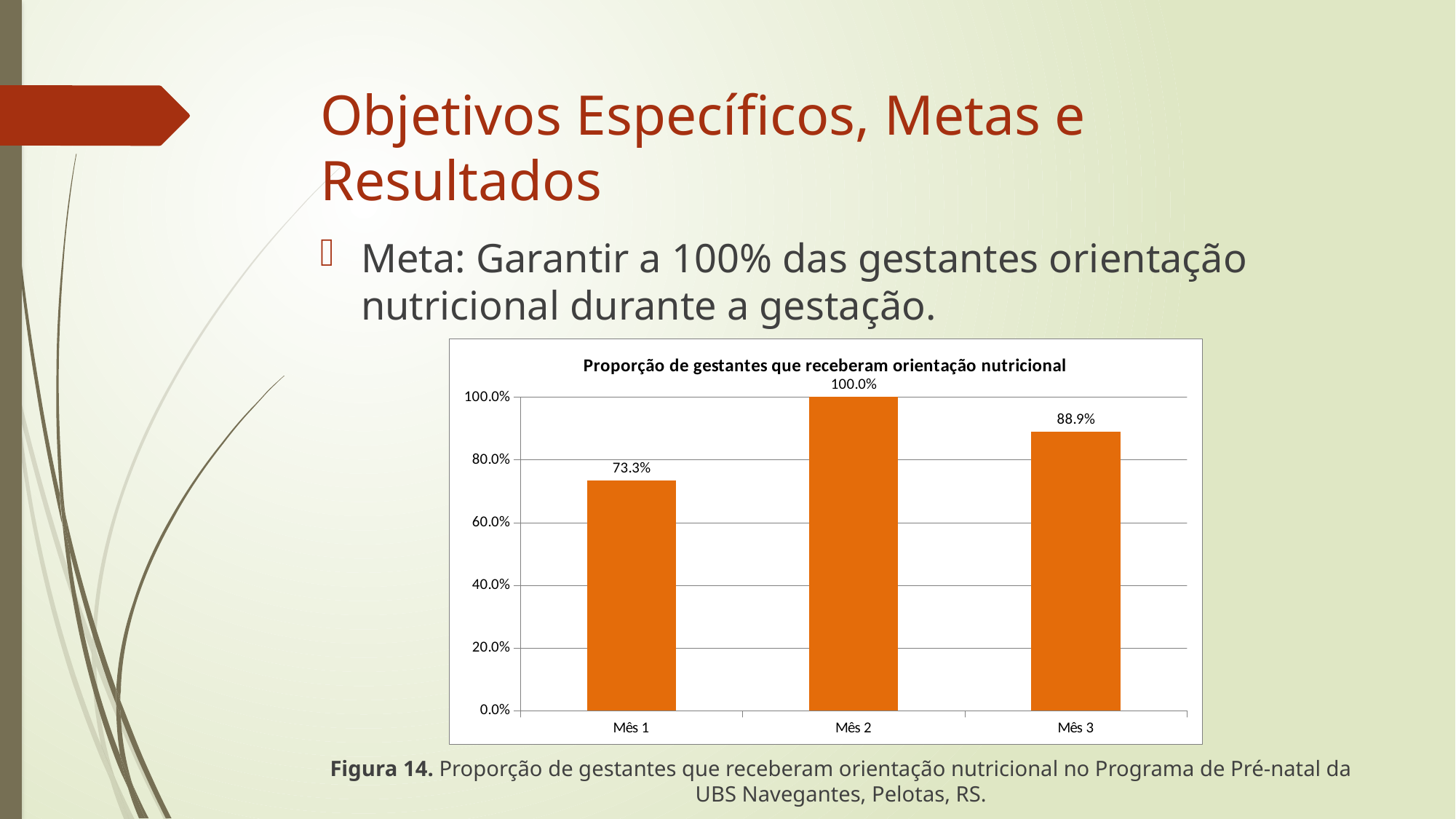
Which month has the highest proportion? Mês 2 What is the title of the chart? Proporção de gestantes que receberam orientação nutricional How many months are shown on the x axis? 3 What is the value for Mês 2? 100.0% What is the difference between the values for Mês 3 and Mês 1? 15.6% What is the difference between the values for Mês 2 and Mês 1? 26.7% Which is larger, the value for Mês 3 or the value for Mês 1? Mês 3 What kind of chart is shown? bar chart Which month has the lowest proportion? Mês 1 What is the value for Mês 3? 88.9% Is the value for Mês 1 greater or less than 80.0%? less What is the value for Mês 1? 73.3%